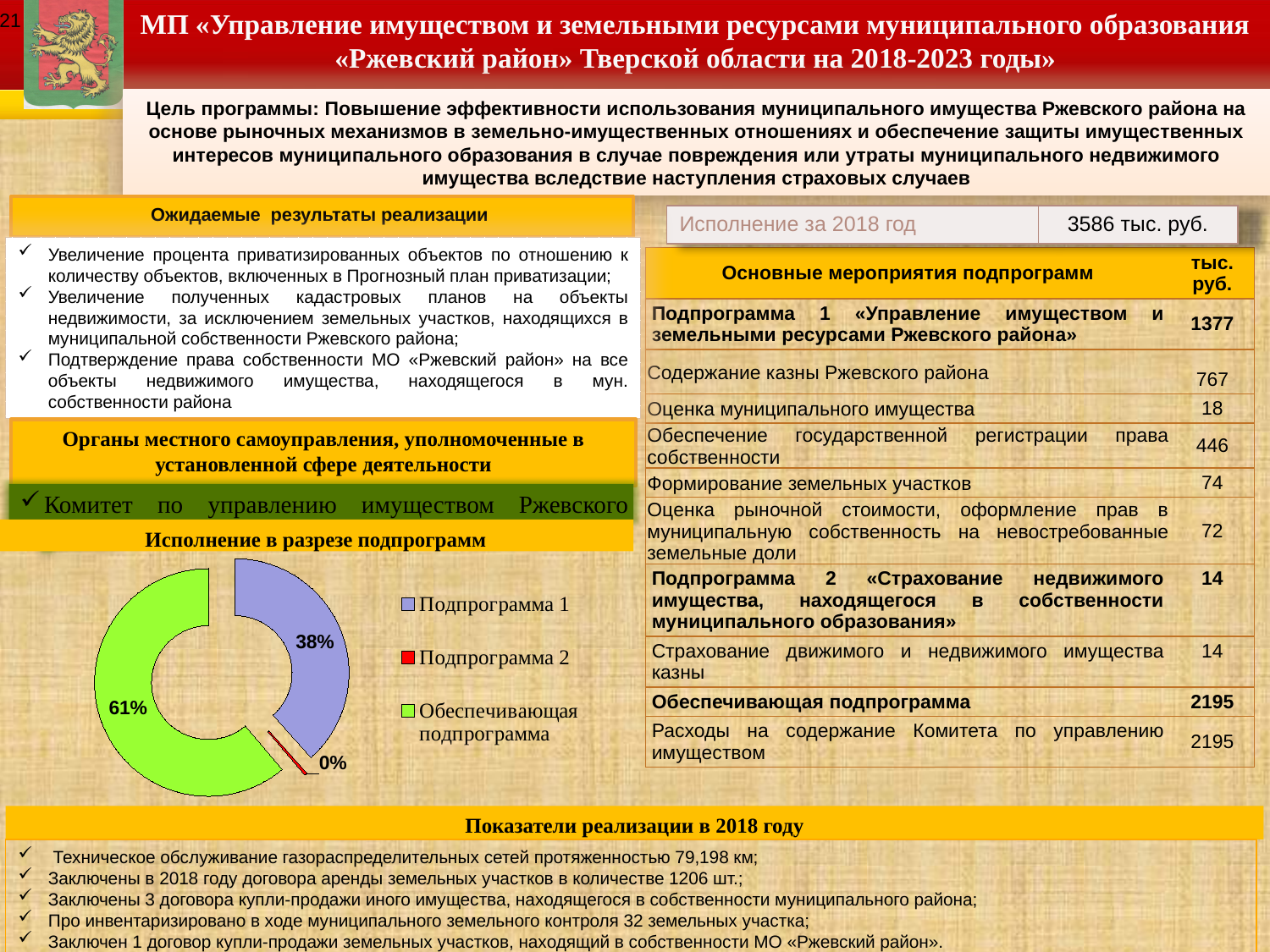
In the chart "Исполнение в разрезе подпрограмм", what share is shown for Подпрограмма 1? 38% In the chart "Исполнение в разрезе подпрограмм", is the share of Подпрограмма 1 greater or less than 50%? less In the chart "Исполнение в разрезе подпрограмм", which subprogram has the largest share? Обеспечивающая подпрограмма In the chart "Исполнение в разрезе подпрограмм", what colour is the slice for Обеспечивающая подпрограмма? Green In the chart "Исполнение в разрезе подпрограмм", which subprogram has the smallest share? Подпрограмма 2 In the chart "Исполнение в разрезе подпрограмм", what share is shown for Обеспечивающая подпрограмма? 61% In the chart "Исполнение в разрезе подпрограмм", which is larger: the share of Подпрограмма 1 or the share of Обеспечивающая подпрограмма? Обеспечивающая подпрограмма How many slices does the chart "Исполнение в разрезе подпрограмм" have? 3 In the chart "Исполнение в разрезе подпрограмм", what share is shown for Подпрограмма 2? 0% In the chart "Исполнение в разрезе подпрограмм", by how many percentage points does the share of Обеспечивающая подпрограмма exceed that of Подпрограмма 1? 23 percentage points How many entries does the legend of the chart "Исполнение в разрезе подпрограмм" list? 3 What kind of chart is "Исполнение в разрезе подпрограмм"? Doughnut (pie) chart